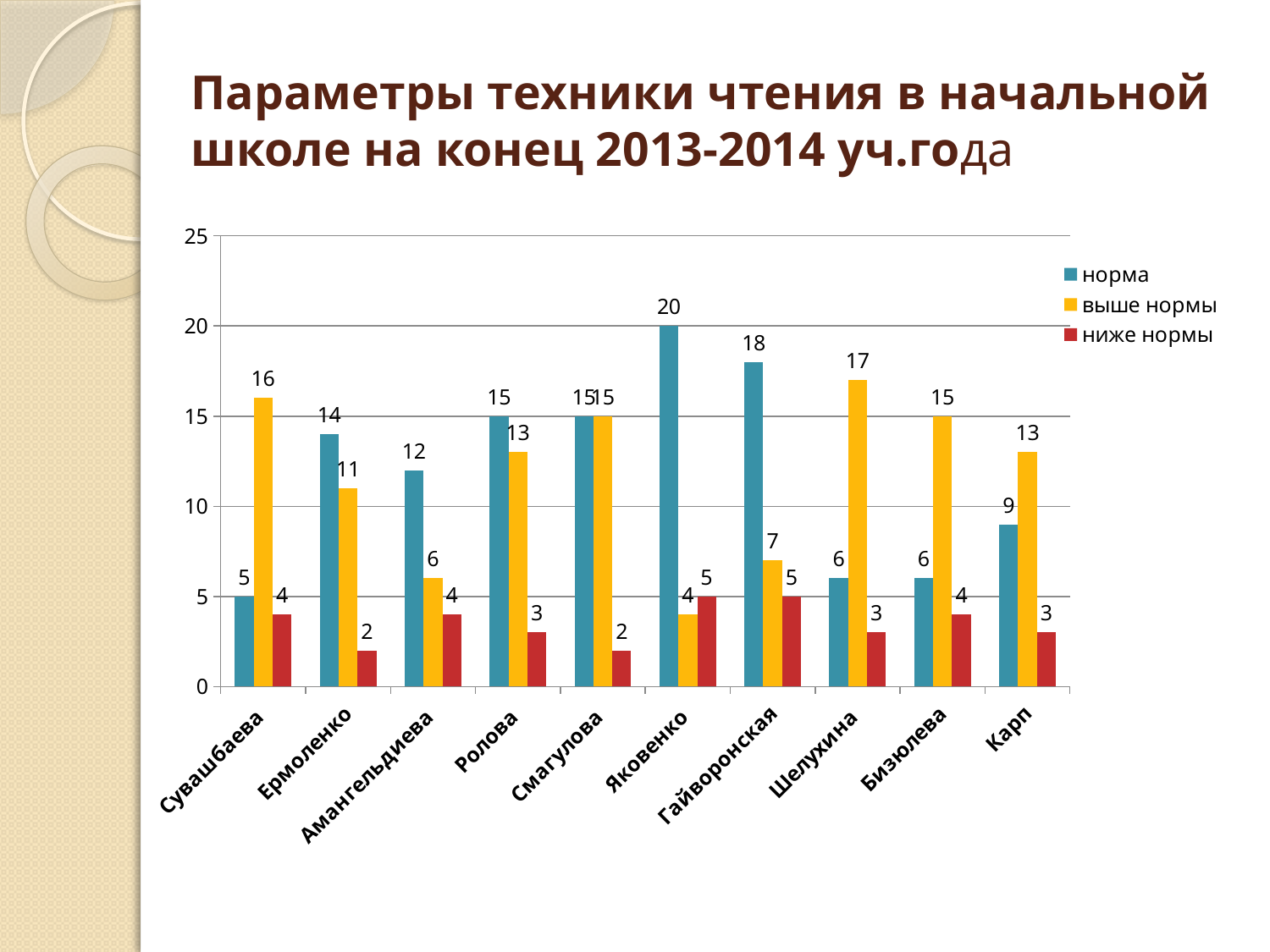
What kind of chart is shown on the slide? bar chart Which category has the highest value in the норма series? Яковенко Which series is shown in red in the legend? ниже нормы Which category has the lowest value in the норма series? Сувашбаева How many categories are shown on the x axis? 10 What is the value of the ниже нормы series for Ермоленко? 2 How many series does the legend list? 3 What is the difference between the норма and выше нормы values for Гайворонская? 11 Which is larger for Карп: the норма value or the выше нормы value? выше нормы What is the value of the норма series for Яковенко? 20 What is the value of the выше нормы series for Шелухина? 17 Which category has the highest value in the выше нормы series? Шелухина